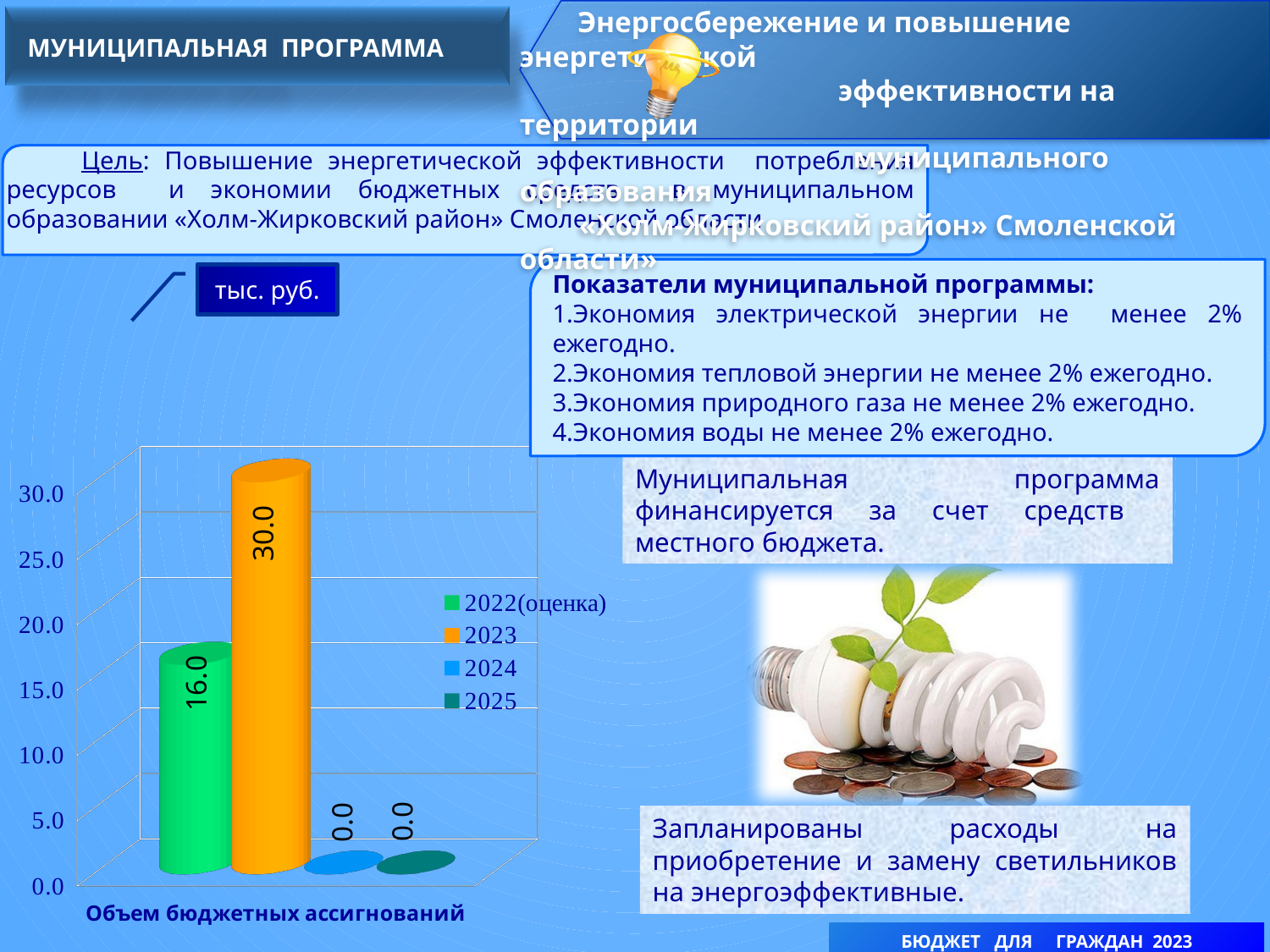
How many series does the legend list? 4 What is the value for 2022(оценка) in the chart? 16.0 What is the value for 2025 in the chart? 0.0 Which is larger, the value for 2022(оценка) or the value for 2023? 2023 What is the difference between the values for 2023 and 2022(оценка)? 14.0 Which series has the highest value in the chart? 2023 Is the value for 2022(оценка) greater or less than 20.0? less What unit is indicated for the chart values? тыс. руб. What is the value for 2023 in the chart? 30.0 What is the category label shown under the chart? Объем бюджетных ассигнований What is the value for 2024 in the chart? 0.0 What kind of chart is shown on the slide? bar chart